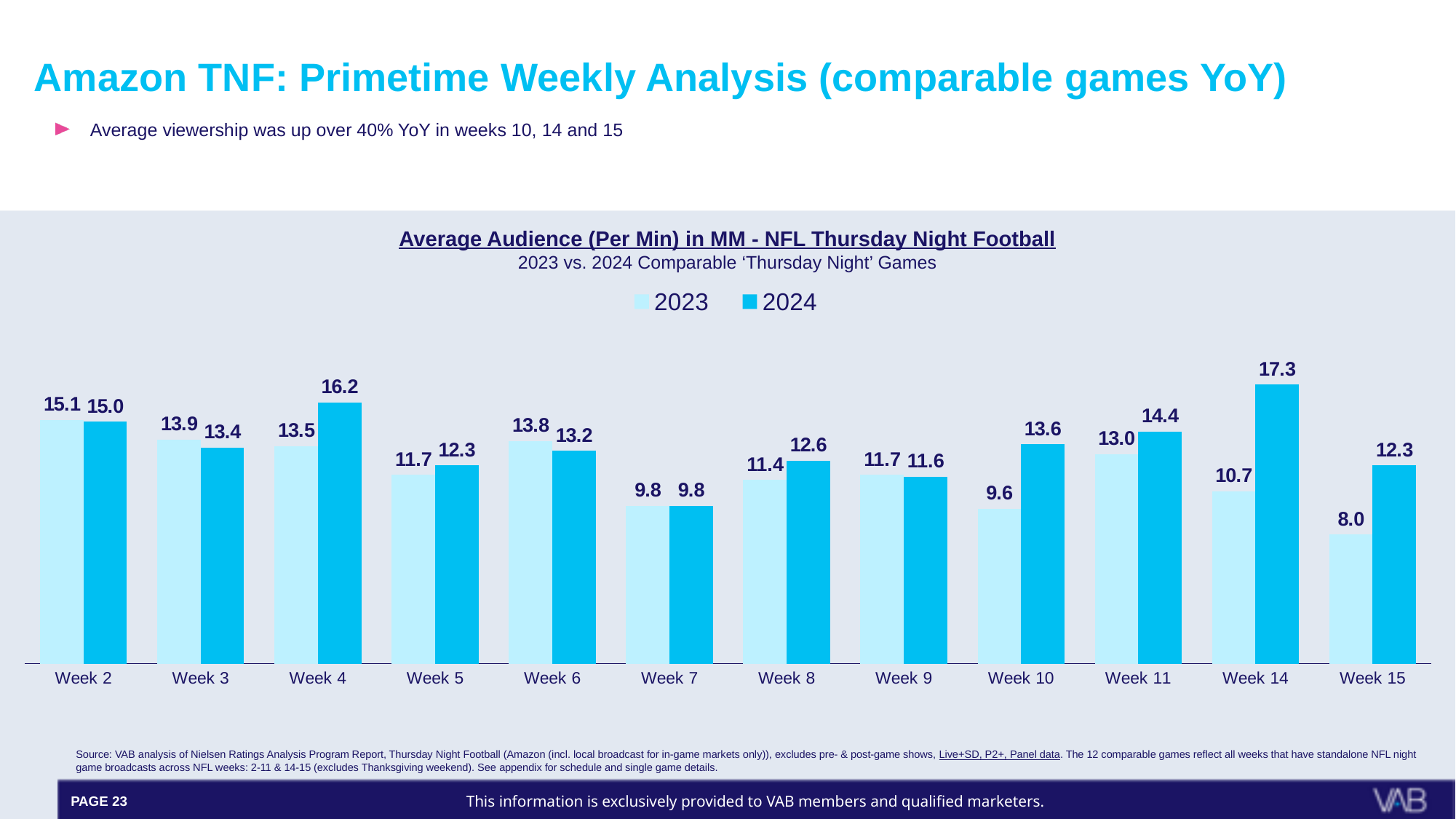
What is the 2024 value for Week 14? 17.3 What is the difference between the 2024 and 2023 values for Week 14? 6.6 Which week has the lowest 2023 value? Week 15 Which is larger for Week 3, the 2023 value or the 2024 value? 2023 Which week has the highest 2024 value? Week 14 How many series does the legend list? 2 How many weeks are shown on the x axis? 12 What is the difference between the 2024 and 2023 values for Week 10? 4.0 What kind of chart is shown? Bar chart What is the 2023 value for Week 15? 8.0 What is the 2023 value for Week 10? 9.6 Which is larger for Week 4, the 2023 value or the 2024 value? 2024